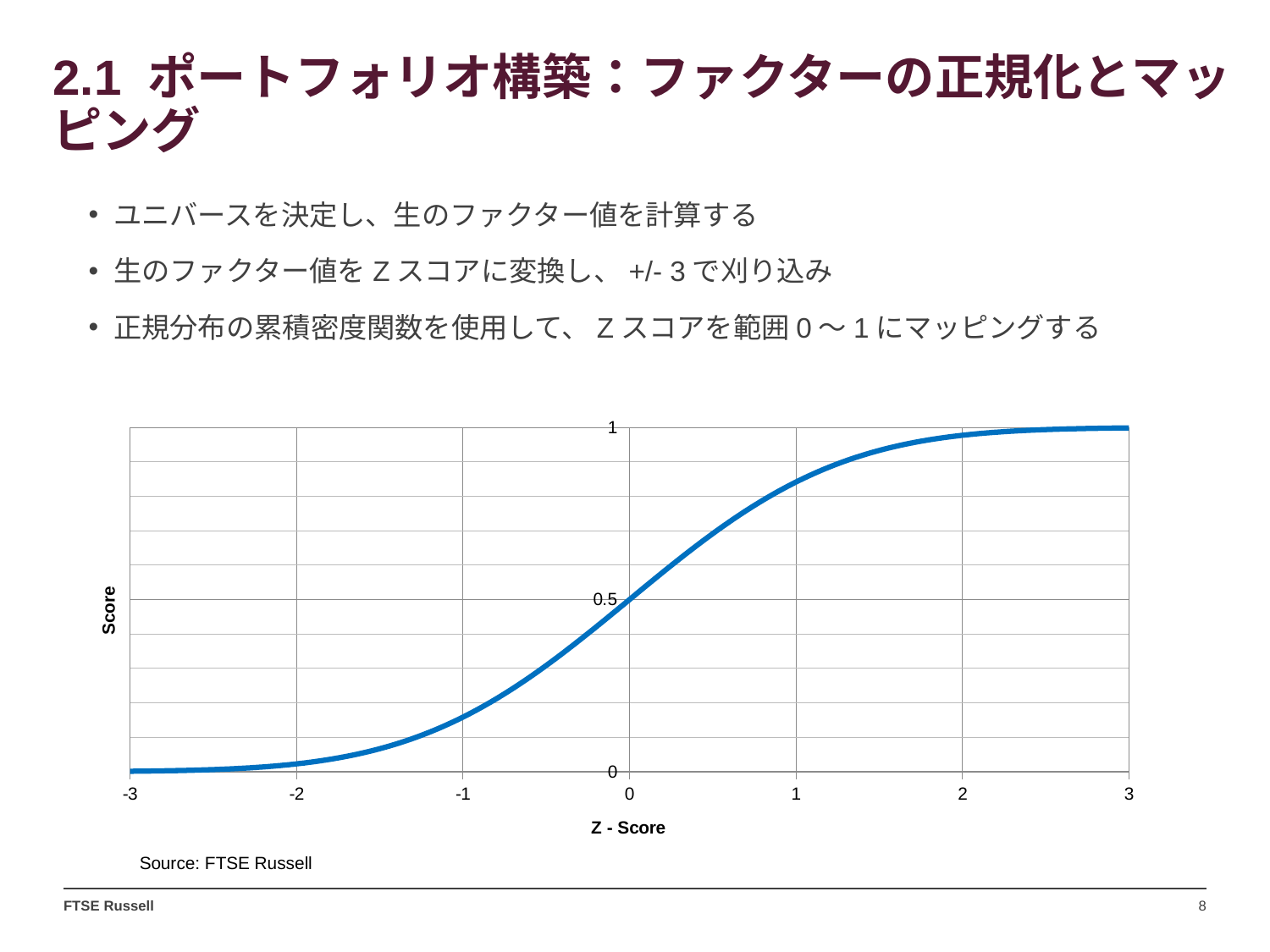
Is the Score at a Z-Score of 2 greater or less than 0.5? greater What is the label of the y axis of the chart? Score What is the Score when the Z-Score is 0? 0.5 What kind of chart is shown on the slide? line chart Is the Score at a Z-Score of 1 greater or less than 0.5? greater Is the Score at a Z-Score of -1 greater or less than 0.5? less At which labelled Z-Score on the x axis is the Score lowest? -3 What is the label of the x axis of the chart? Z - Score At which labelled Z-Score on the x axis is the Score highest? 3 Which has the higher Score: a Z-Score of -2 or a Z-Score of 2? 2 Does the Score rise or fall as the Z-Score increases from -3 to 3? rise